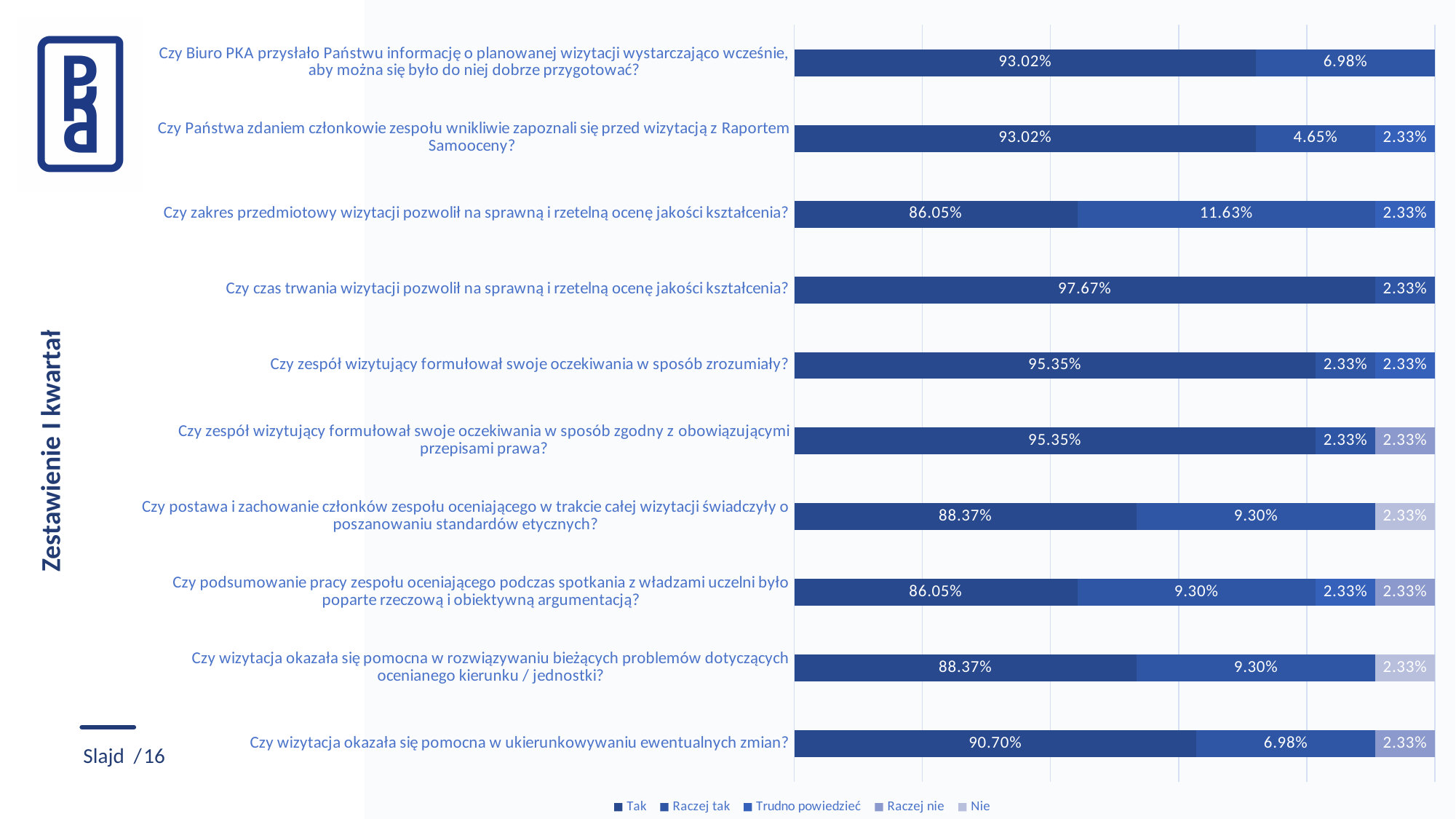
What is the difference between the 'Tak' value for 'Czy czas trwania wizytacji pozwolił na sprawną i rzetelną ocenę jakości kształcenia?' and the 'Tak' value for 'Czy Biuro PKA przysłało Państwu informację o planowanej wizytacji wystarczająco wcześnie, aby można się było do niej dobrze przygotować?' 4.65% What is the vertical title text on the left side of the slide? Zestawienie I kwartał Which question has the highest 'Tak' value? Czy czas trwania wizytacji pozwolił na sprawną i rzetelną ocenę jakości kształcenia? Which has a larger 'Tak' value: 'Czy zespół wizytujący formułował swoje oczekiwania w sposób zrozumiały?' or 'Czy postawa i zachowanie członków zespołu oceniającego w trakcie całej wizytacji świadczyły o poszanowaniu standardów etycznych?' Czy zespół wizytujący formułował swoje oczekiwania w sposób zrozumiały? What is the 'Tak' value for 'Czy wizytacja okazała się pomocna w ukierunkowywaniu ewentualnych zmian?' 90.70% What is the first entry in the chart legend? Tak How many series does the legend list? 5 What is the 'Raczej tak' value for 'Czy zakres przedmiotowy wizytacji pozwolił na sprawną i rzetelną ocenę jakości kształcenia?' 11.63% What type of chart is shown on the slide? stacked bar chart How many questions (categories) are plotted in the chart? 10 What is the total of the stacked bar for 'Czy Biuro PKA przysłało Państwu informację o planowanej wizytacji wystarczająco wcześnie, aby można się było do niej dobrze przygotować?' 100.00% What is the 'Tak' value for 'Czy czas trwania wizytacji pozwolił na sprawną i rzetelną ocenę jakości kształcenia?' 97.67%